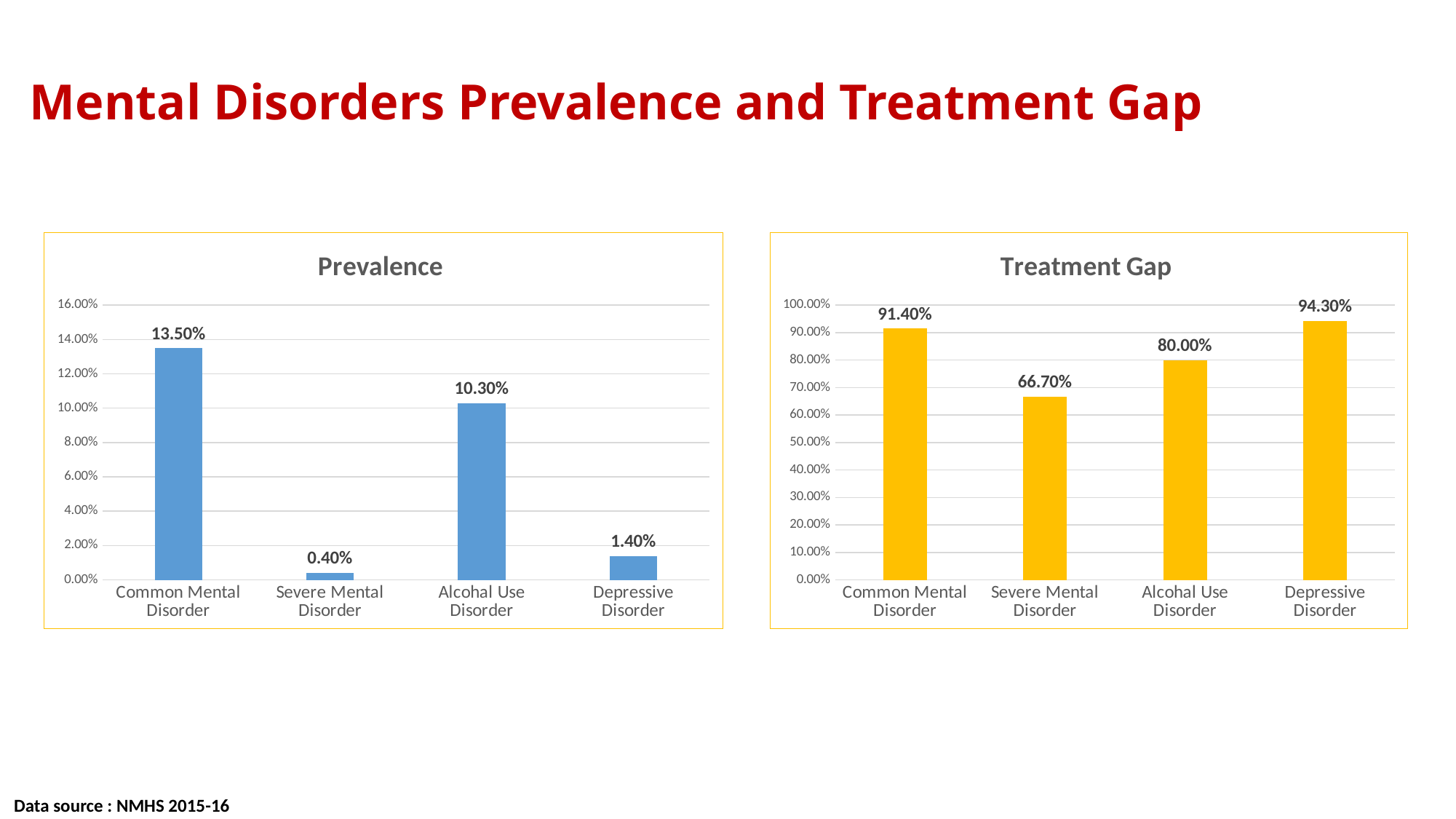
In the Treatment Gap chart, what is the value for Alcohol Use Disorder? 80.00% In the Prevalence chart, which is larger: Depressive Disorder or Severe Mental Disorder? Depressive Disorder In the Treatment Gap chart, what is the value for Severe Mental Disorder? 66.70% In the Treatment Gap chart, which category has the lowest value? Severe Mental Disorder In the Prevalence chart, what is the value for Severe Mental Disorder? 0.40% In the Prevalence chart, what is the value for Common Mental Disorder? 13.50% What kind of chart is the Prevalence chart? Bar chart How many categories are shown in the Treatment Gap chart? 4 In the Treatment Gap chart, which category has the highest value? Depressive Disorder In the Prevalence chart, what is the difference between Common Mental Disorder and Alcohol Use Disorder? 3.20% In the Treatment Gap chart, what is the difference between Depressive Disorder and Severe Mental Disorder? 27.60% In the Prevalence chart, which category has the highest value? Common Mental Disorder